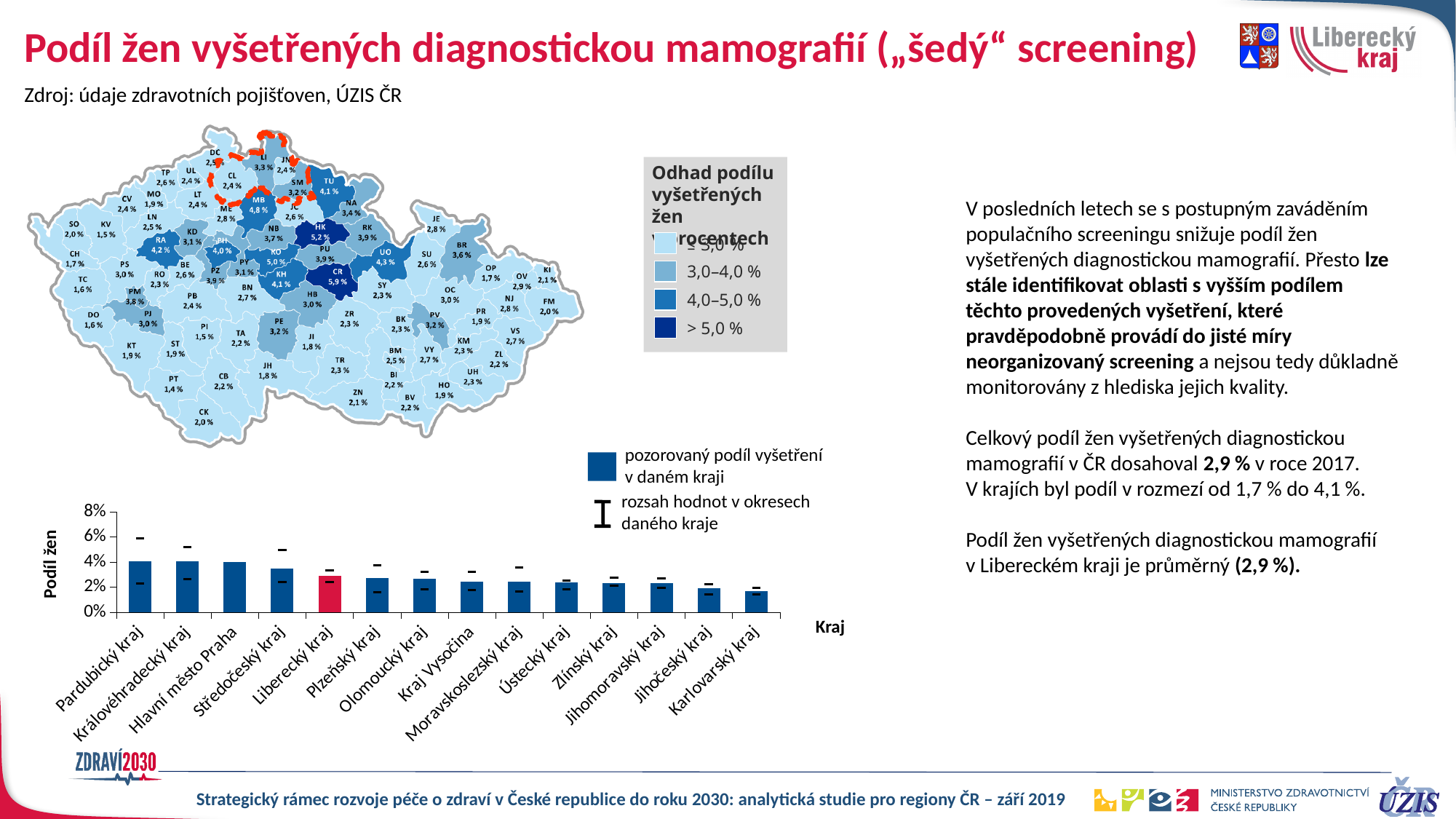
On the map, what is the value shown for district HK? 5,2 % In the bar chart, is the value for Středočeský kraj greater or less than 4%? less In the bar chart, which region's bar is highlighted in red? Liberecký kraj In the bar chart, do the values rise or fall from left to right along the x axis? fall What kind of chart is shown at the bottom left of the slide? bar chart In the bar chart, which has the larger value: Středočeský kraj or Plzeňský kraj? Středočeský kraj How many categories does the map legend list? 4 In the bar chart, which region has the lowest observed share of examined women? Karlovarský kraj In the bar chart, how many regions (kraje) are shown on the x axis? 14 On the map, which district has the highest estimated share of examined women? CR (5,9 %) In the bar chart, is the value for Karlovarský kraj greater or less than 2%? less